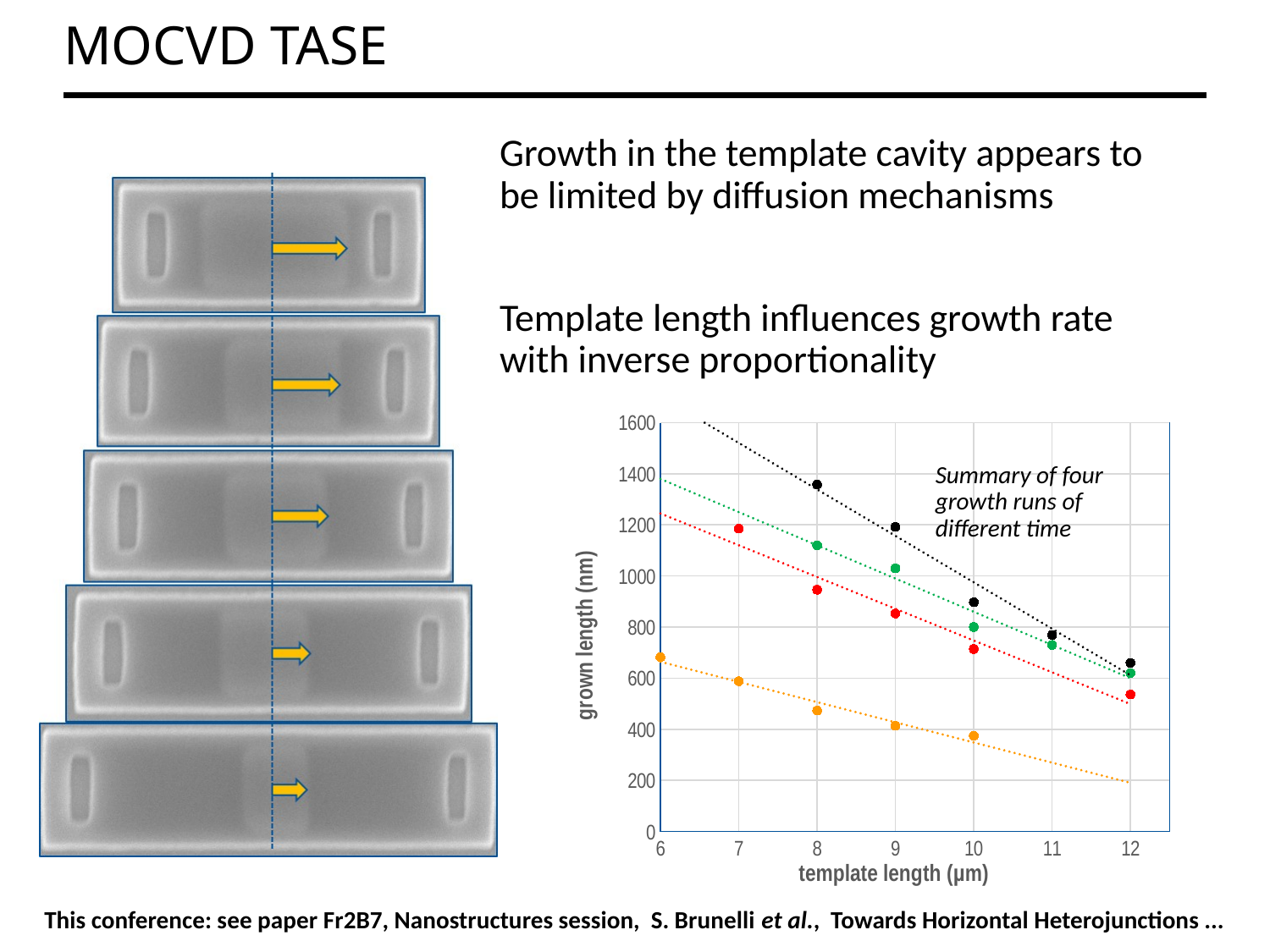
Is the black series value at a template length of 8 µm greater or less than 1200 nm? greater Is the orange series value at a template length of 10 µm greater or less than 600 nm? less Which series has the lowest grown length values in the chart? orange series Is the red series value at a template length of 7 µm greater or less than 1000 nm? greater As template length increases along the x axis, do the grown length values rise or fall? fall At a template length of 8 µm, which series has the larger grown length, the black series or the orange series? black series What is the label of the y axis of the chart? grown length (nm) What is the label of the x axis of the chart? template length (µm) How many growth runs (series) are plotted in the chart? 4 What kind of chart is shown on the slide? scatter chart